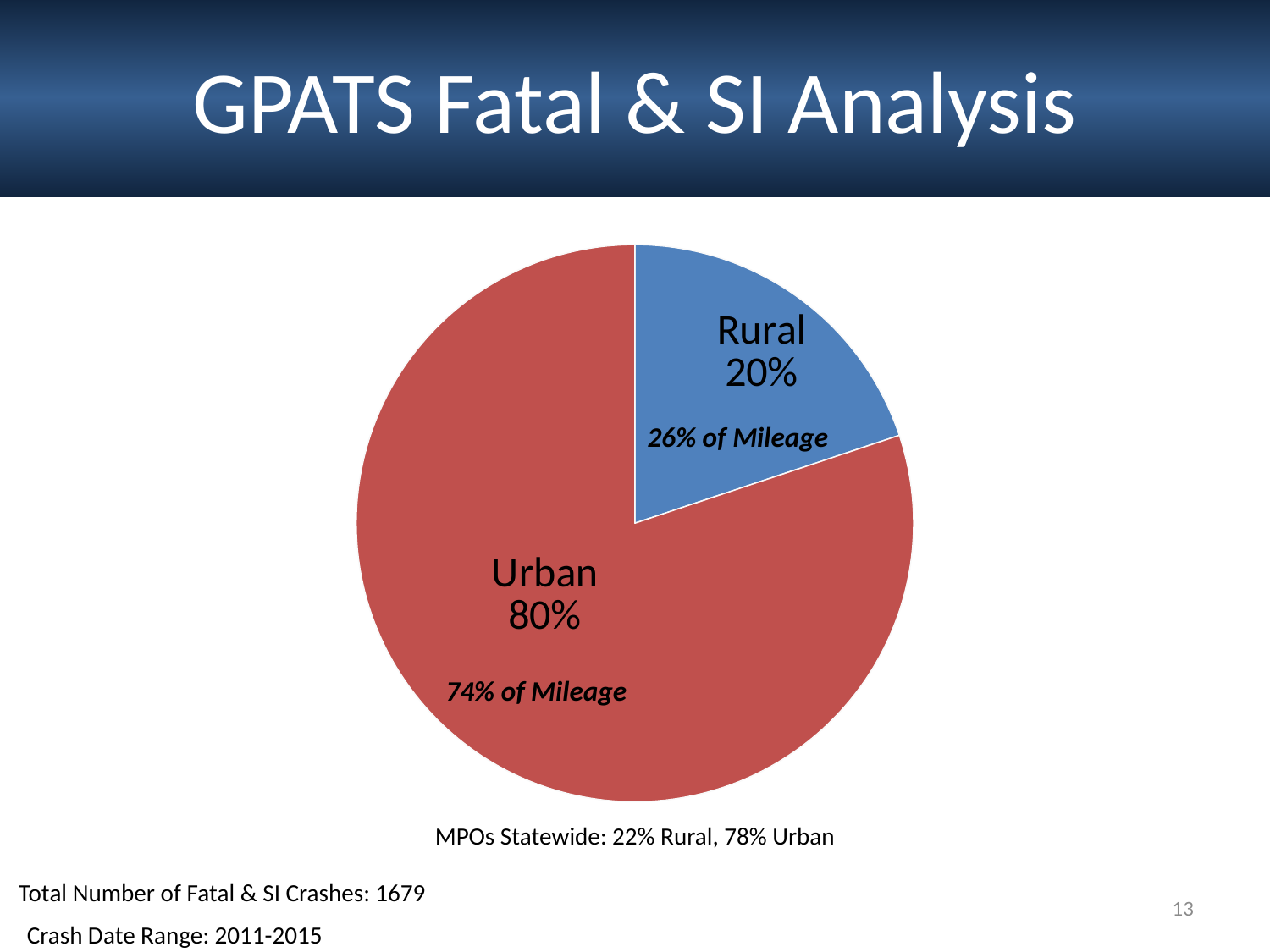
What percentage of mileage is noted for the Rural slice? 26% of Mileage What share of the pie does the Rural slice represent? 20% Which slice is larger, Rural or Urban? Urban What colour is the Urban slice of the pie? red Which slice of the pie is the largest? Urban What share of the pie does the Urban slice represent? 80% What is the title of the slide containing the pie chart? GPATS Fatal & SI Analysis What kind of chart is shown on the slide? pie chart What percentage of mileage is noted for the Urban slice? 74% of Mileage How many slices does the pie chart have? 2 What is the difference in percentage points between the Urban and Rural slices? 60% Which slice of the pie is the smallest? Rural